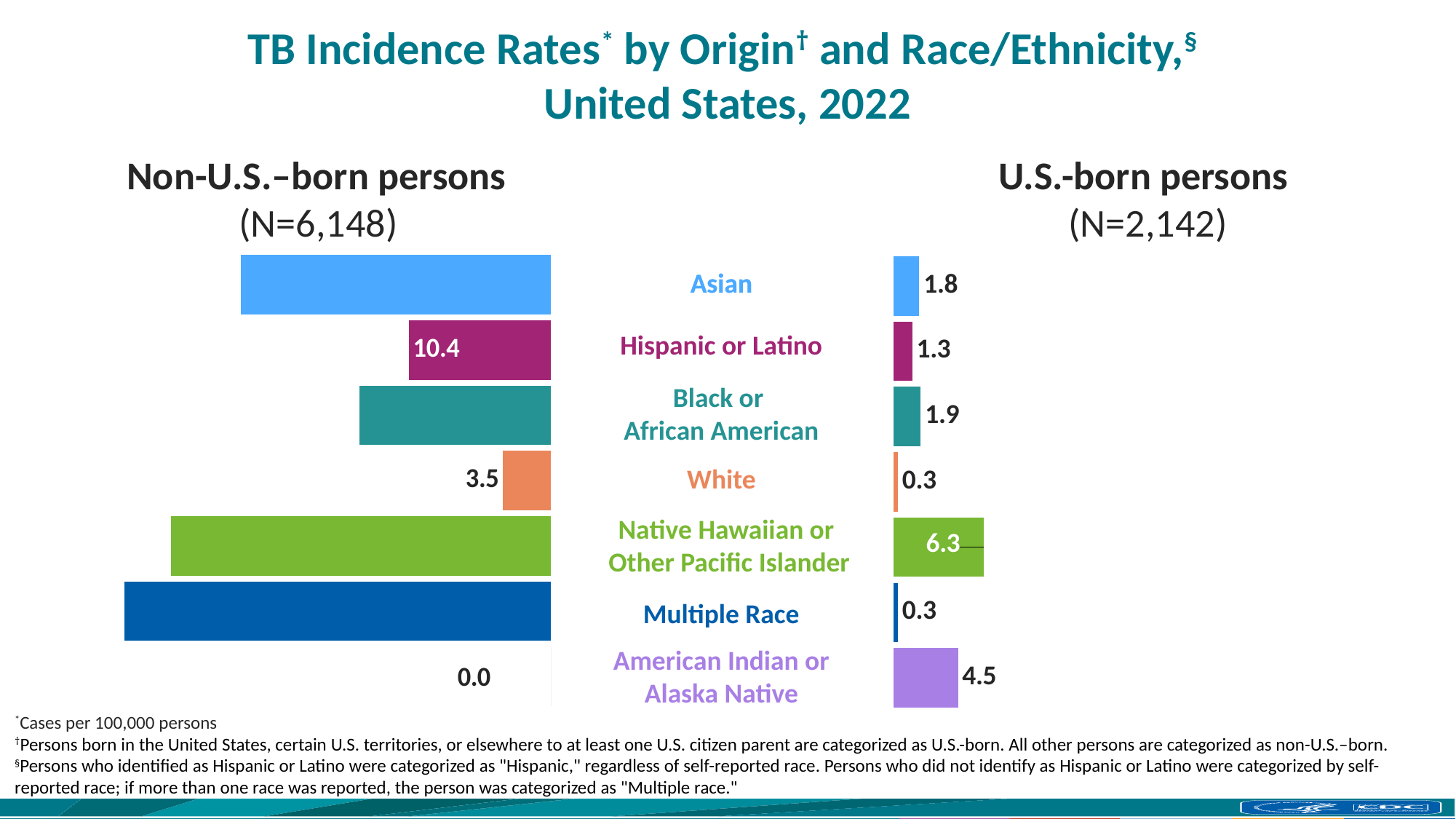
In the Non-U.S.-born persons chart, which race/ethnicity group has the longest bar? Multiple Race In the U.S.-born persons chart, which race/ethnicity group has the highest TB incidence rate? Native Hawaiian or Other Pacific Islander In the U.S.-born persons chart, what is the TB incidence rate for American Indian or Alaska Native persons? 4.5 In the Non-U.S.-born persons chart, which race/ethnicity group has the lowest TB incidence rate? American Indian or Alaska Native In the Non-U.S.-born persons chart, what is the TB incidence rate for Hispanic or Latino persons? 10.4 How many race/ethnicity categories are shown in the U.S.-born persons chart? 7 In the U.S.-born persons chart, what is the difference between the rates for Native Hawaiian or Other Pacific Islander and American Indian or Alaska Native persons? 1.8 In the Non-U.S.-born persons chart, which is larger: the rate for Hispanic or Latino persons or the rate for White persons? Hispanic or Latino In the U.S.-born persons chart, what is the TB incidence rate for Black or African American persons? 1.9 In the Non-U.S.-born persons chart, what is the TB incidence rate for White persons? 3.5 In the U.S.-born persons chart, what is the TB incidence rate for Native Hawaiian or Other Pacific Islander persons? 6.3 What type of chart is used to show the TB incidence rates on this slide? Bar chart